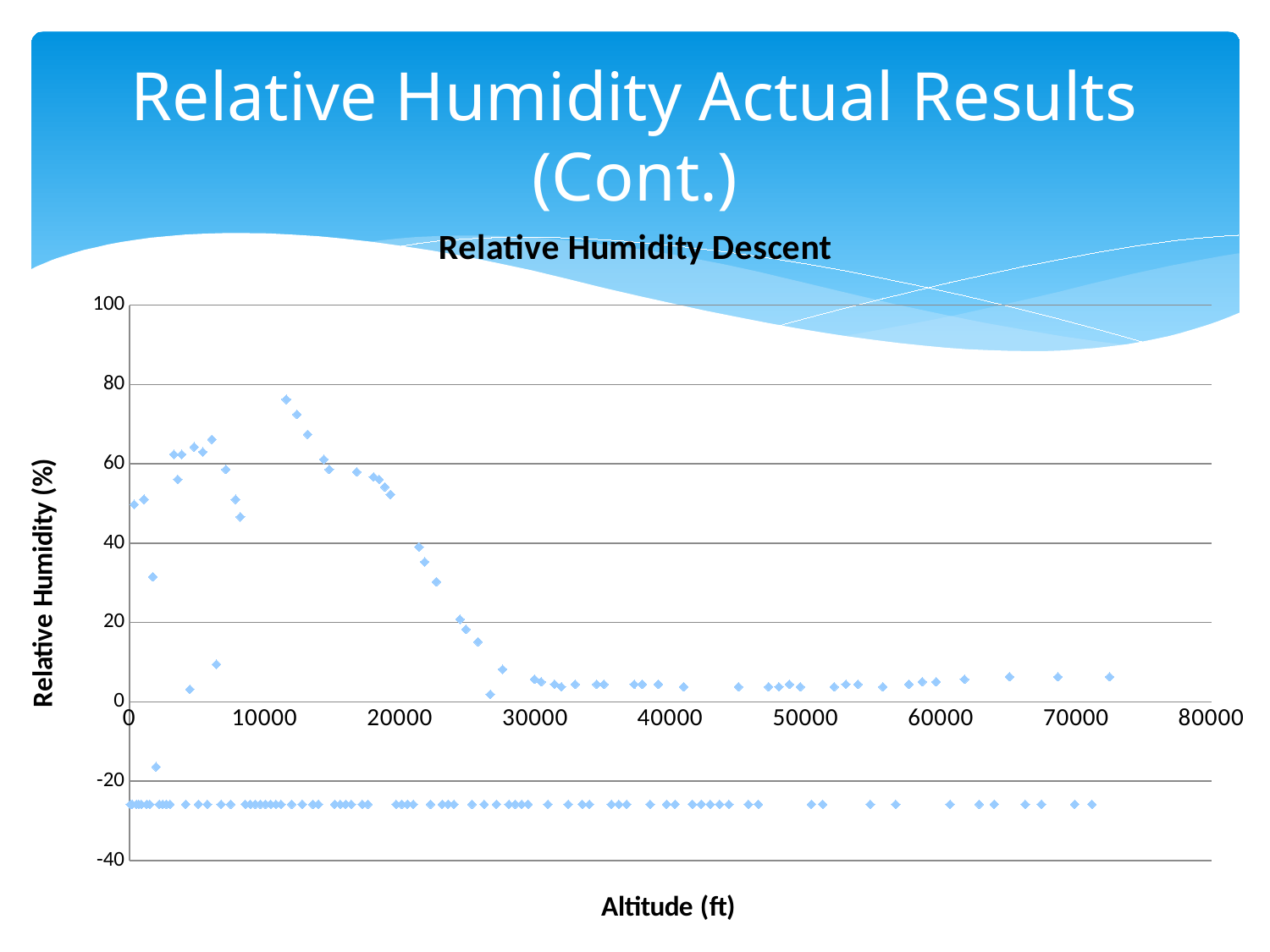
Are the relative humidity values plotted around 5000 ft in the upper cluster greater or less than 40? greater What is the title of the chart? Relative Humidity Descent Which is larger: the relative humidity plotted near 12000 ft or the relative humidity plotted near 50000 ft? near 12000 ft Are the relative humidity values plotted around 50000 ft greater or less than 20? less Is the highest relative humidity value plotted (near 12000 ft) greater or less than 80? less What is the label on the vertical axis of the chart? Relative Humidity (%) Between 20000 ft and 30000 ft, do the upper relative humidity values rise or fall as altitude increases? fall What kind of chart is shown on the slide? scatter chart